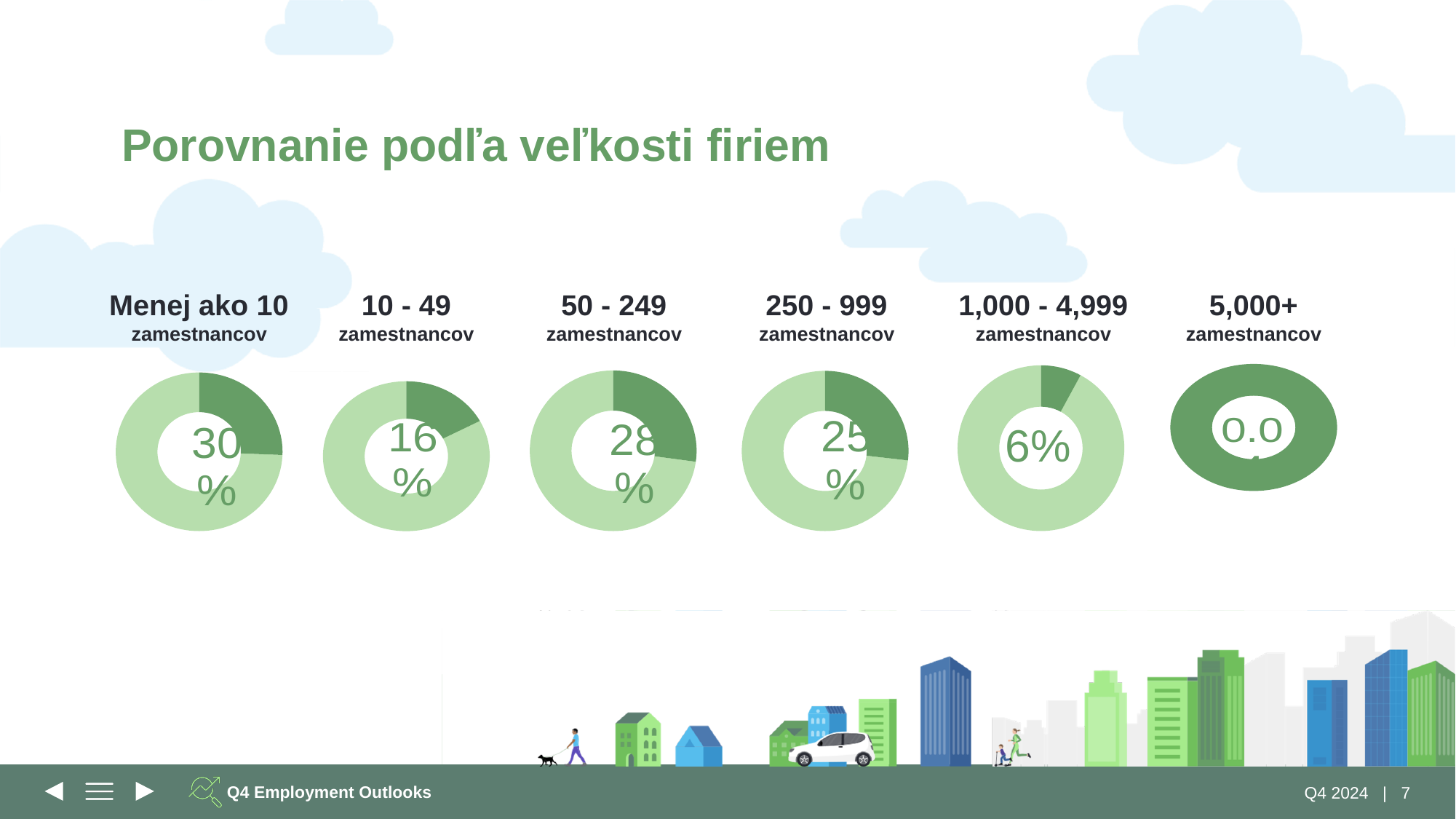
What value is shown in the donut chart for 'Menej ako 10 zamestnancov'? 30% What value is shown in the donut chart for '1,000 - 4,999 zamestnancov'? 6% What is the difference between the values for 'Menej ako 10 zamestnancov' and '10 - 49 zamestnancov'? 14% What value is shown in the donut chart for '50 - 249 zamestnancov'? 28% What value is shown in the donut chart for '10 - 49 zamestnancov'? 16% Among the five donut charts with readable percentage labels, which company size category has the lowest value? 1,000 - 4,999 zamestnancov What value is shown in the donut chart for '250 - 999 zamestnancov'? 25% How many donut charts are shown on the slide? 6 Which company size category has the highest value among the donut charts? Menej ako 10 zamestnancov What is the title of the slide containing the donut charts? Porovnanie podľa veľkosti firiem What type of chart is used to show the values for each company size category? Donut chart Which is larger: the value for '50 - 249 zamestnancov' or the value for '250 - 999 zamestnancov'? 50 - 249 zamestnancov